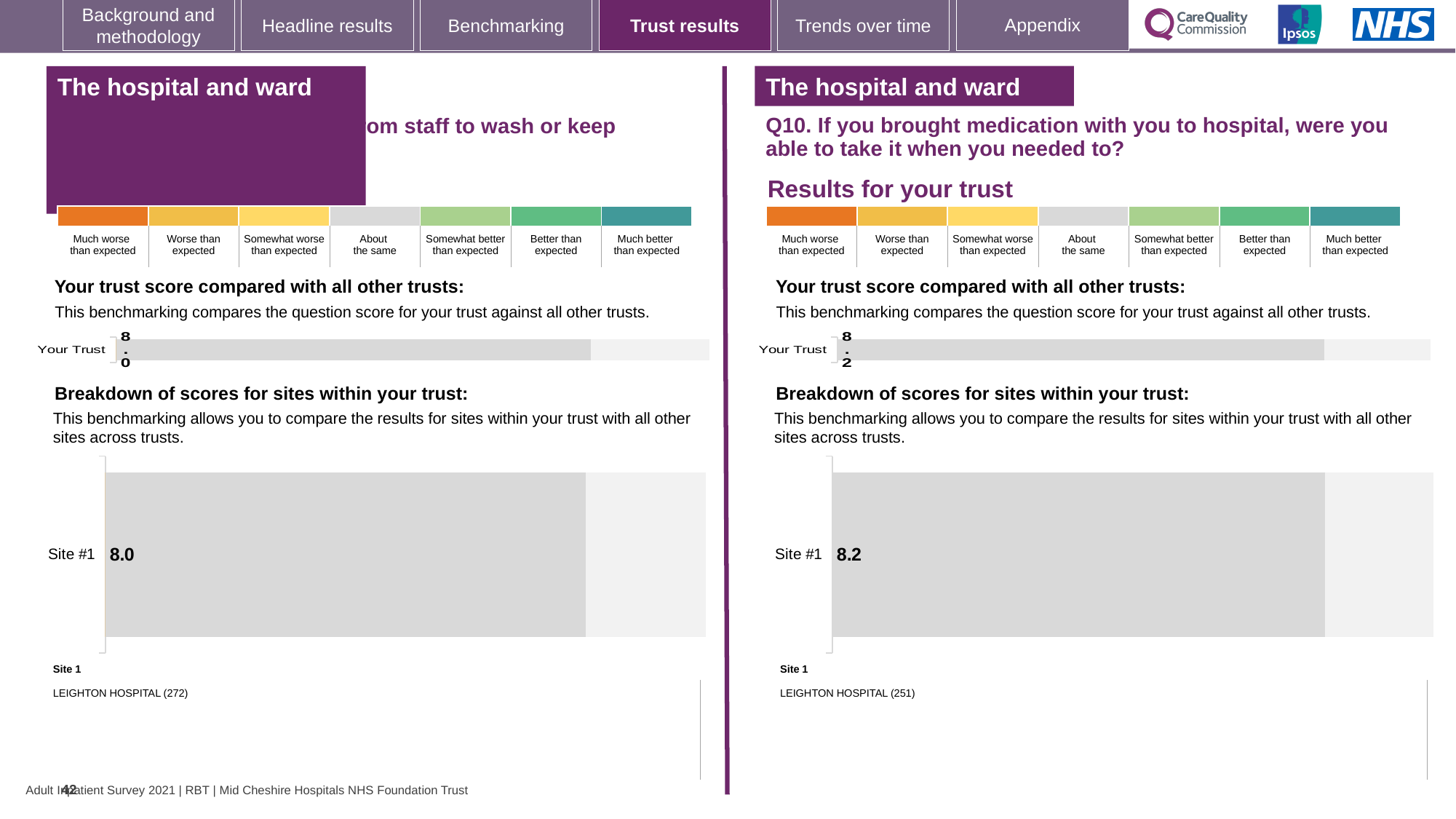
On the left half of the slide, what is the score shown for Your Trust? 8.0 What is the difference between the Site #1 score on the right half (Q10) and the Site #1 score on the left half of the slide? 0.2 On the right half of the slide (Q10), which site name is listed under Site 1? LEIGHTON HOSPITAL (251) On the left half of the slide, what is the score shown for Site #1? 8.0 On the left half of the slide, which site name is listed under Site 1? LEIGHTON HOSPITAL (272) What kind of chart is used to show the Site #1 score on the right half of the slide (Q10)? Bar chart On the right half of the slide (Q10), is the Your Trust score greater or less than 8.0? greater How many sites are shown in the breakdown of scores chart on the right half of the slide (Q10)? 1 On the right half of the slide (Q10), what is the score shown for Site #1? 8.2 Which is larger: the Site #1 score on the left half of the slide or the Site #1 score on the right half (Q10)? Right half (Q10) On the right half of the slide (Q10), what is the score shown for Your Trust? 8.2